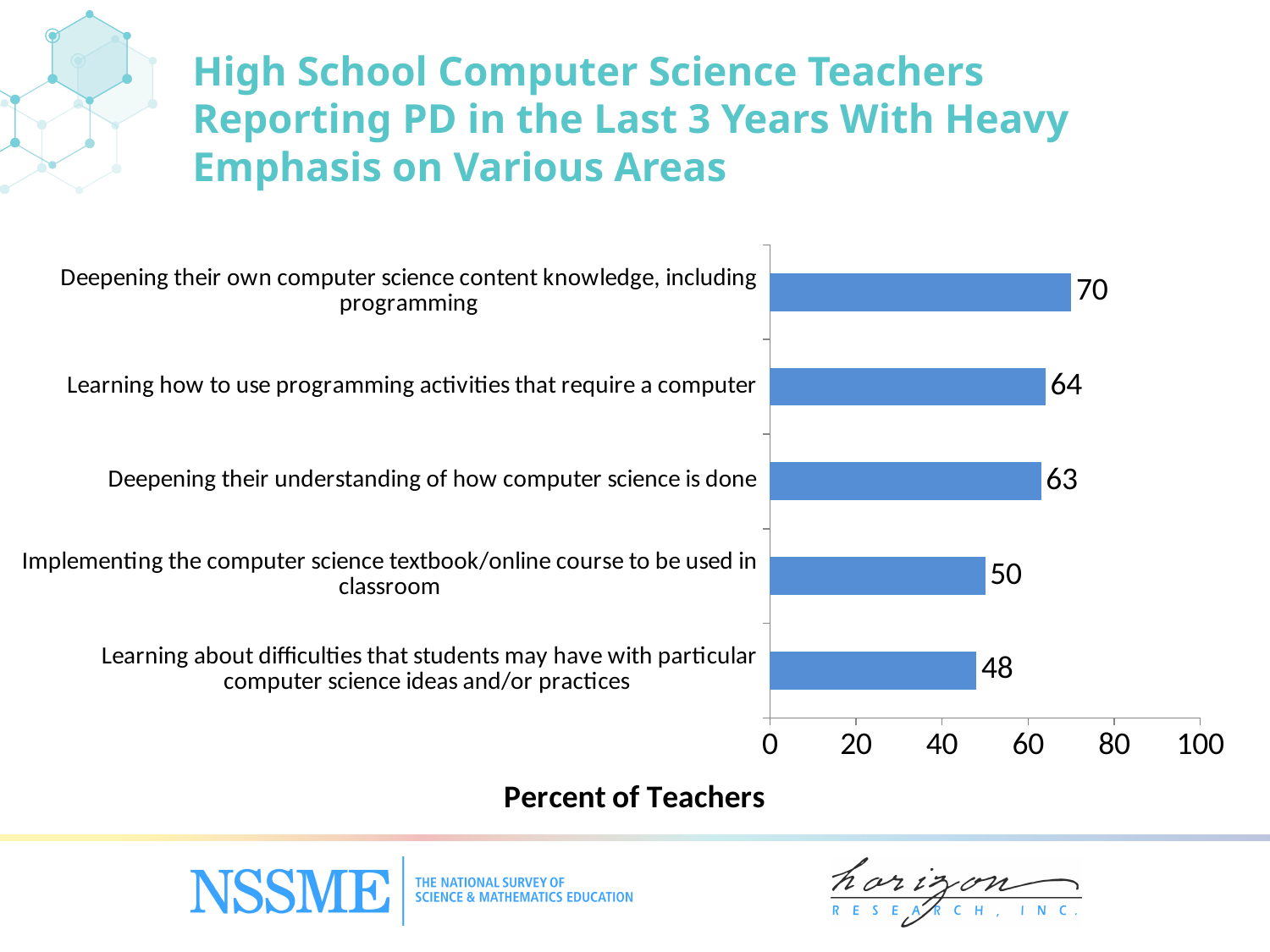
Is the value for learning how to use programming activities that require a computer greater or less than 60? greater How many areas are shown in the chart? 5 Which area has the lowest percent of teachers? Learning about difficulties that students may have with particular computer science ideas and/or practices Which is larger: the value for deepening their understanding of how computer science is done or the value for implementing the computer science textbook/online course to be used in classroom? Deepening their understanding of how computer science is done What is the label of the horizontal axis? Percent of Teachers What is the difference between the value for deepening their own computer science content knowledge and the value for implementing the computer science textbook/online course? 20 What is the maximum value shown on the horizontal axis? 100 What kind of chart is shown on the slide? Bar chart Which area has the highest percent of teachers? Deepening their own computer science content knowledge, including programming What percent of teachers reported PD with heavy emphasis on deepening their own computer science content knowledge, including programming? 70 What is the value for learning how to use programming activities that require a computer? 64 What is the value for learning about difficulties that students may have with particular computer science ideas and/or practices? 48